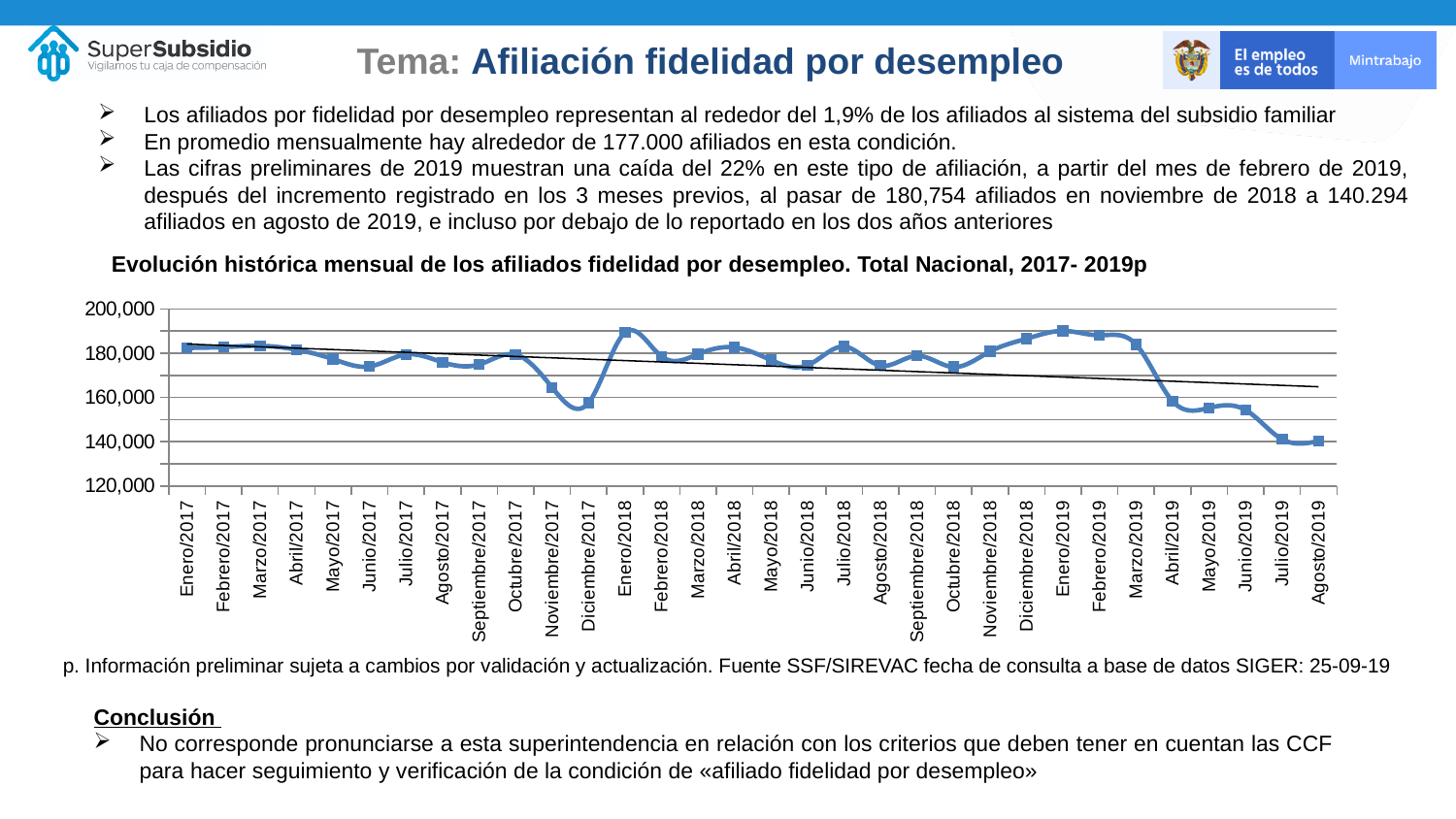
What is the highest value shown on the vertical axis? 200,000 According to the straight trend line drawn on the chart, do the values rise or fall over the period? fall Is the value for Octubre/2018 greater or less than 180,000? less Which is larger, the value for Diciembre/2017 or the value for Diciembre/2018? Diciembre/2018 What is the title of the chart? Evolución histórica mensual de los afiliados fidelidad por desempleo. Total Nacional, 2017- 2019p Is the value for Mayo/2019 greater or less than 160,000? less Is the value for Enero/2018 greater or less than 180,000? greater What kind of chart is shown on the slide? line chart Which is larger, the value for Enero/2019 or the value for Agosto/2019? Enero/2019 How many monthly data points are plotted on the chart? 32